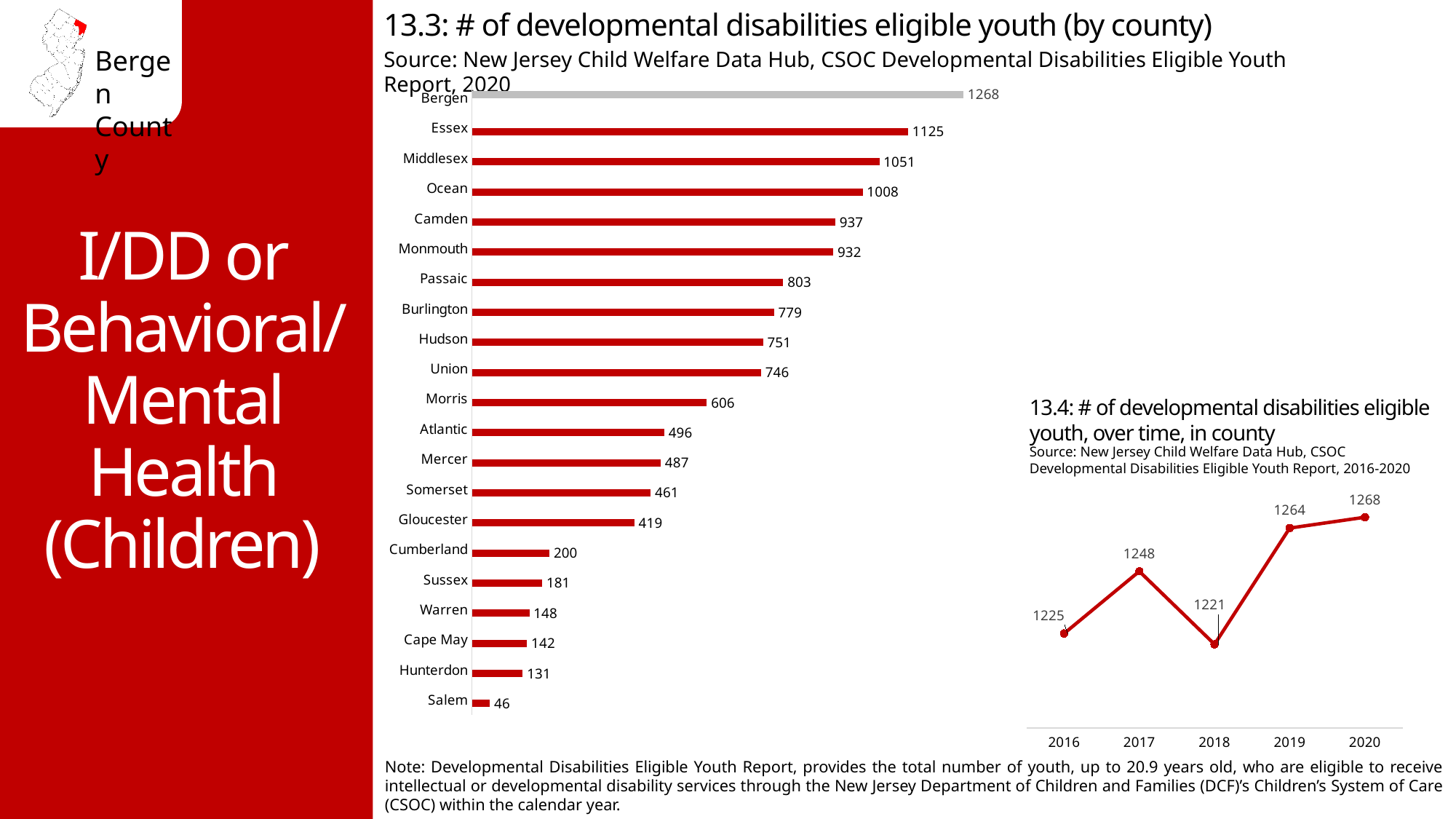
In chart 13.3 (by county), what is the value for Hunterdon? 131 What kind of chart is chart 13.3 (# of developmental disabilities eligible youth by county)? Bar chart In chart 13.4 (over time, in county), what is the difference between the values for 2020 and 2016? 43 In chart 13.3 (by county), how many counties are shown? 21 In chart 13.3 (by county), which county has the highest number of developmental disabilities eligible youth? Bergen In chart 13.4 (over time, in county), what is the value for 2018? 1221 In chart 13.3 (# of developmental disabilities eligible youth by county), what is the value for Essex? 1125 What kind of chart is chart 13.4 (# of developmental disabilities eligible youth over time, in county)? Line chart In chart 13.3 (by county), what is the difference between the values for Bergen and Essex? 143 In chart 13.3 (by county), which county has the lowest number of developmental disabilities eligible youth? Salem In chart 13.4 (over time, in county), which year has the lowest value? 2018 In chart 13.3 (by county), which has a larger value, Camden or Passaic? Camden